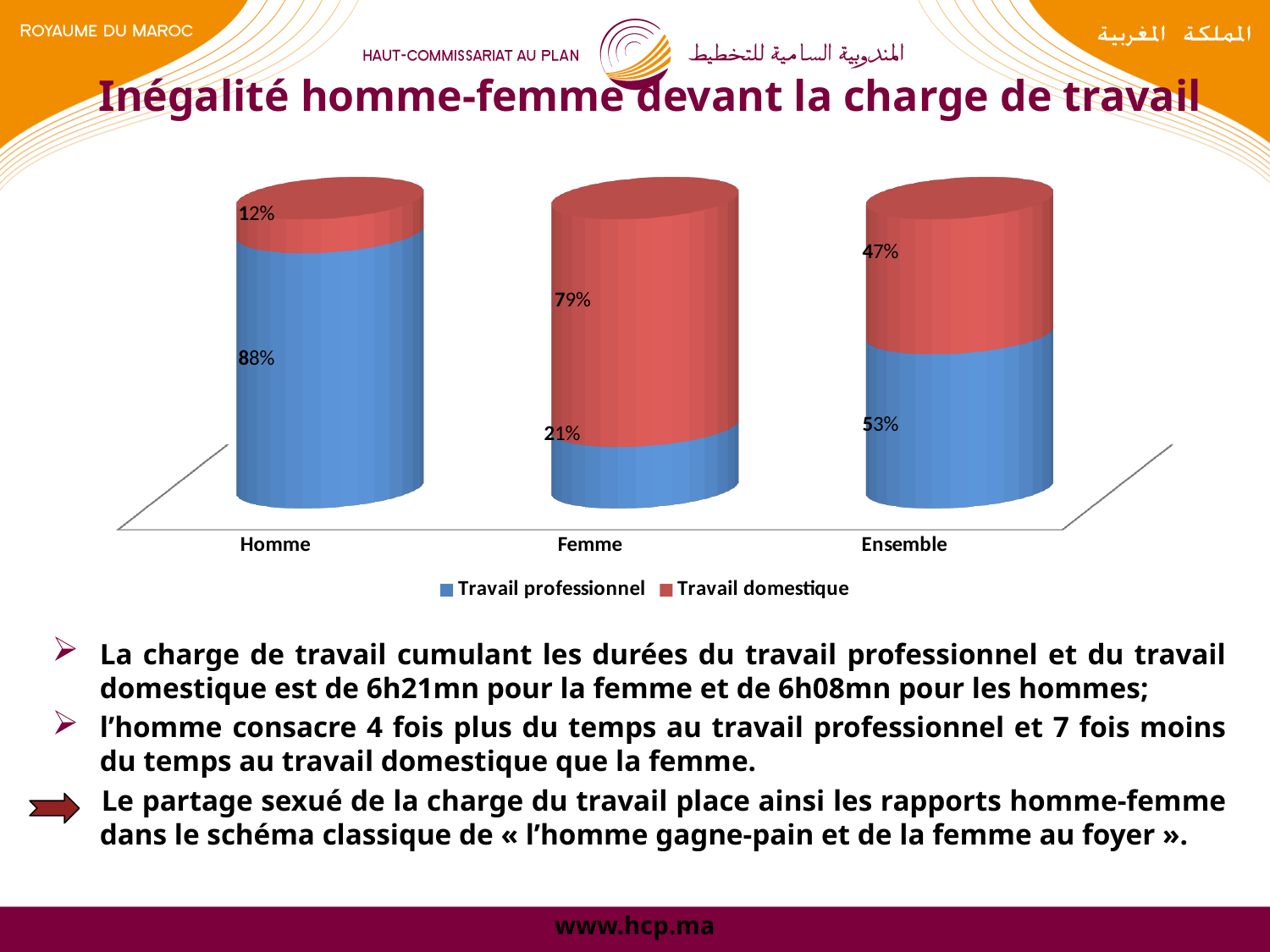
Which category has the lowest value for Travail professionnel? Femme What is the value of Travail professionnel for Ensemble? 53% What is the value of Travail domestique for Femme? 79% Which is larger for Ensemble: Travail professionnel or Travail domestique? Travail professionnel What is the value of Travail professionnel for Homme? 88% What kind of chart is shown on the slide? Stacked bar chart Which category has the highest value for Travail domestique? Femme What is the difference between the Travail professionnel values for Homme and Femme? 67% What is the value of Travail domestique for Homme? 12% How many categories are shown on the x axis? 3 How many series does the legend list? 2 Which colour represents Travail domestique in the chart? Red